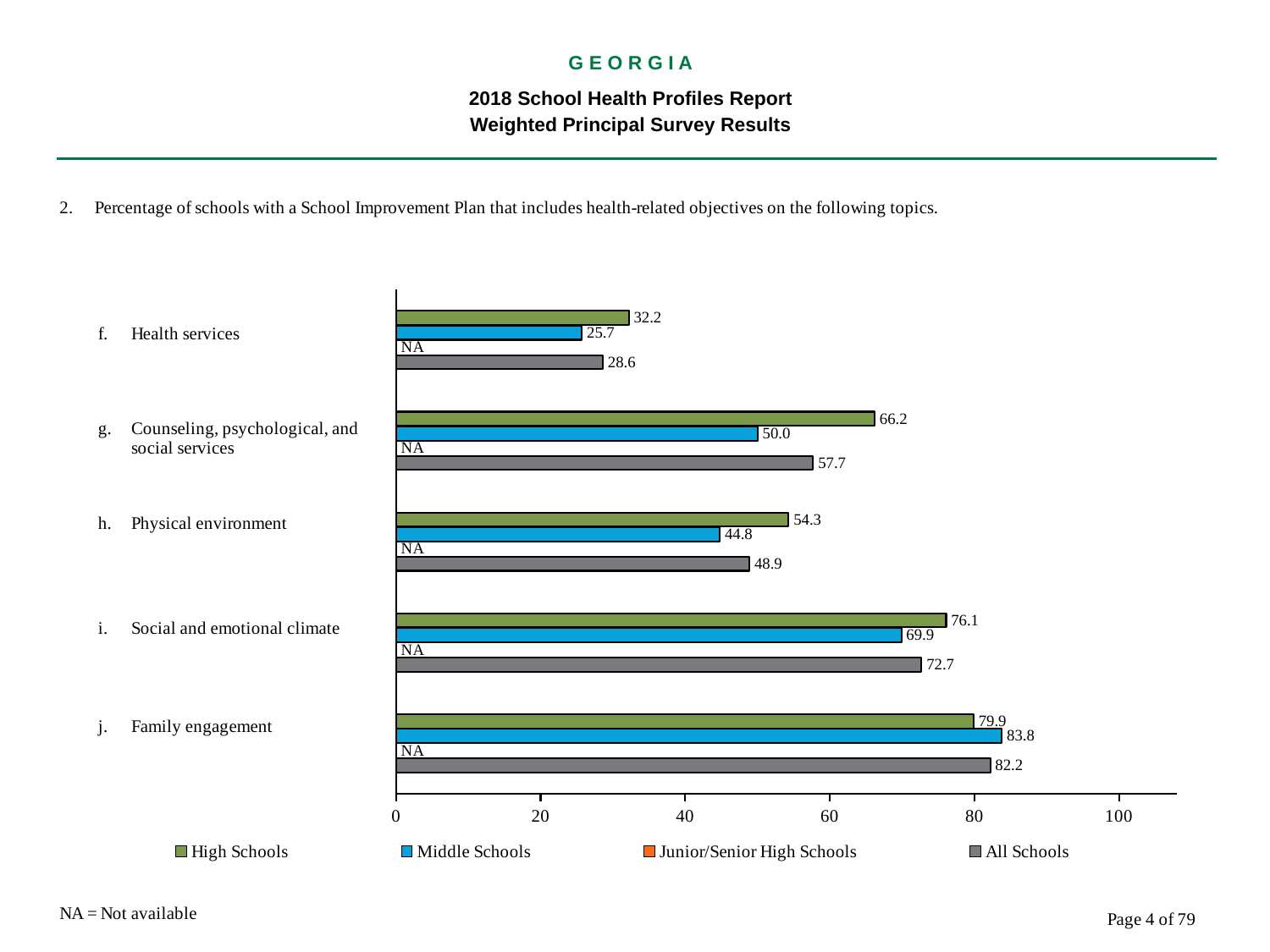
What is the value for High Schools for Health services? 32.2 Which topic has the highest value for High Schools? Family engagement What does NA stand for on the slide? Not available What is the value for Middle Schools for Counseling, psychological, and social services? 50.0 How many topics are shown on the chart? 5 Which topic has the lowest value for Middle Schools? Health services What is the value for Junior/Senior High Schools for Family engagement? NA For Family engagement, which is larger: the High Schools value or the Middle Schools value? Middle Schools What is the value for All Schools for Physical environment? 48.9 What kind of chart is shown on the slide? Bar chart How many series does the legend list? 4 What is the difference between the High Schools and Middle Schools values for Social and emotional climate? 6.2